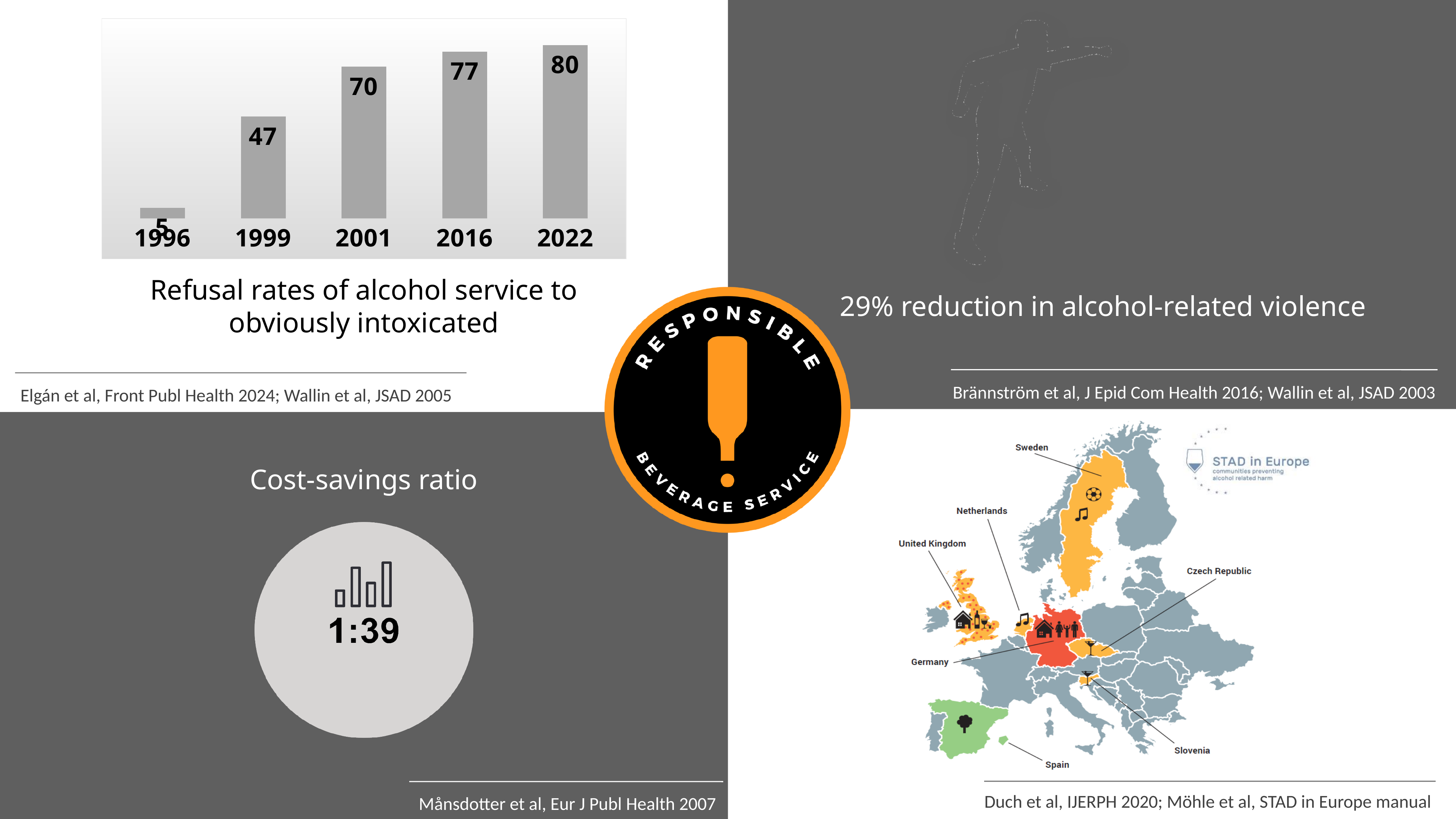
What is the difference between the refusal rates for 2022 and 1996? 75 What is the refusal rate shown for 1999? 47 Which is larger, the refusal rate for 1999 or for 2001? 2001 Do the refusal rates rise or fall from 1996 to 2022? rise What is the refusal rate shown for 2016? 77 What kind of chart shows the refusal rates of alcohol service? bar chart What is the refusal rate shown for 2022? 80 Which year has the highest refusal rate? 2022 Which year has the lowest refusal rate? 1996 What is the refusal rate shown for 2001? 70 What is the refusal rate shown for 1996? 5 How many years are shown in the refusal rates chart? 5